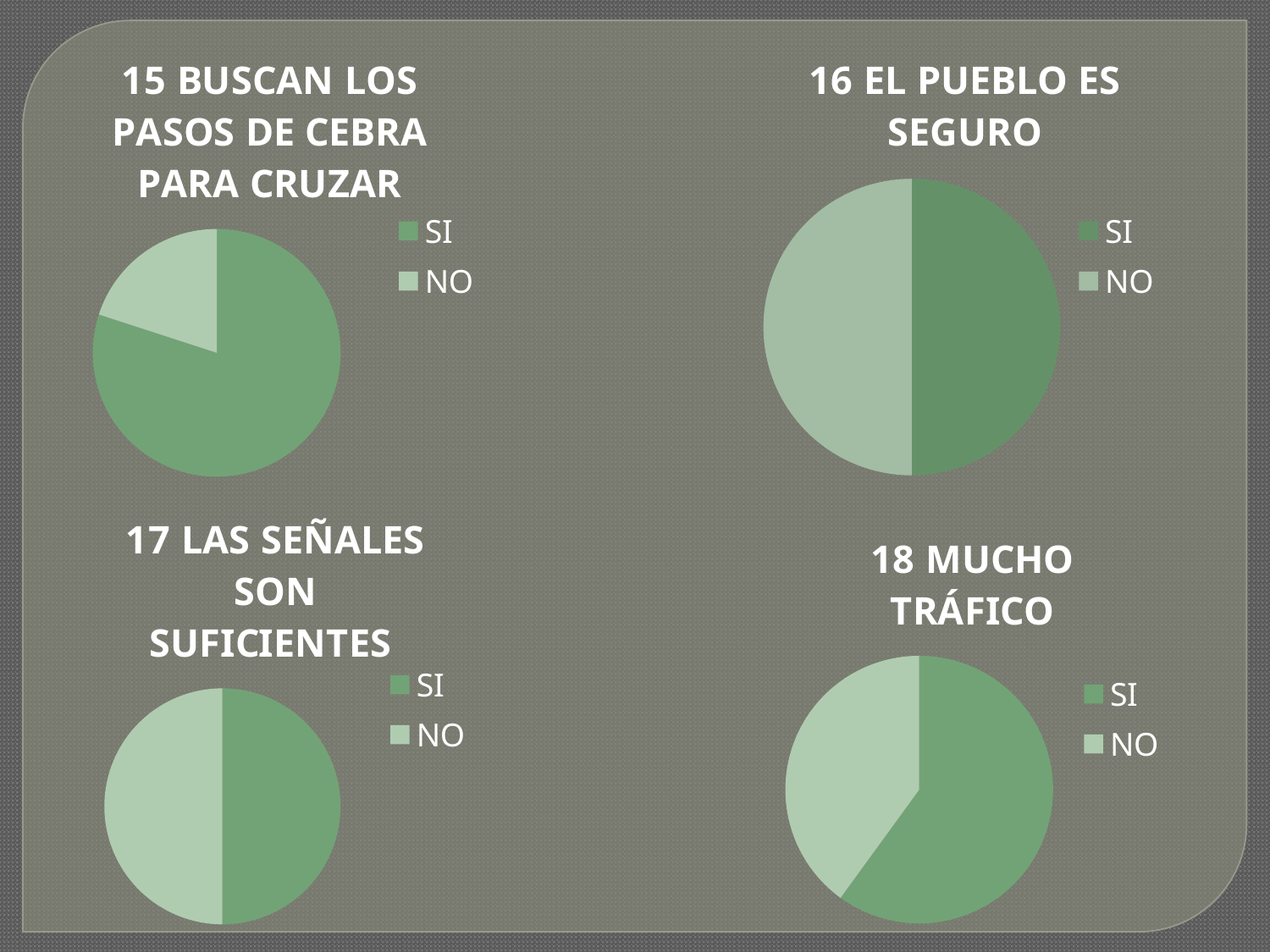
How many entries does the legend of the chart "16 EL PUEBLO ES SEGURO" list? 2 In the chart "18 MUCHO TRÁFICO", which slice is larger, SI or NO? SI What kind of chart is "15 BUSCAN LOS PASOS DE CEBRA PARA CRUZAR"? pie chart In the chart "15 BUSCAN LOS PASOS DE CEBRA PARA CRUZAR", which slice is larger, SI or NO? SI How many slices does the pie chart "17 LAS SEÑALES SON SUFICIENTES" have? 2 In the chart "18 MUCHO TRÁFICO", which category has the largest slice? SI In the chart "15 BUSCAN LOS PASOS DE CEBRA PARA CRUZAR", which category has the smallest slice? NO What kind of chart is "18 MUCHO TRÁFICO"? pie chart What are the legend entries of the chart "18 MUCHO TRÁFICO"? SI, NO How many charts are shown on the slide? 4 What is the title of the chart in the top-right of the slide? 16 EL PUEBLO ES SEGURO